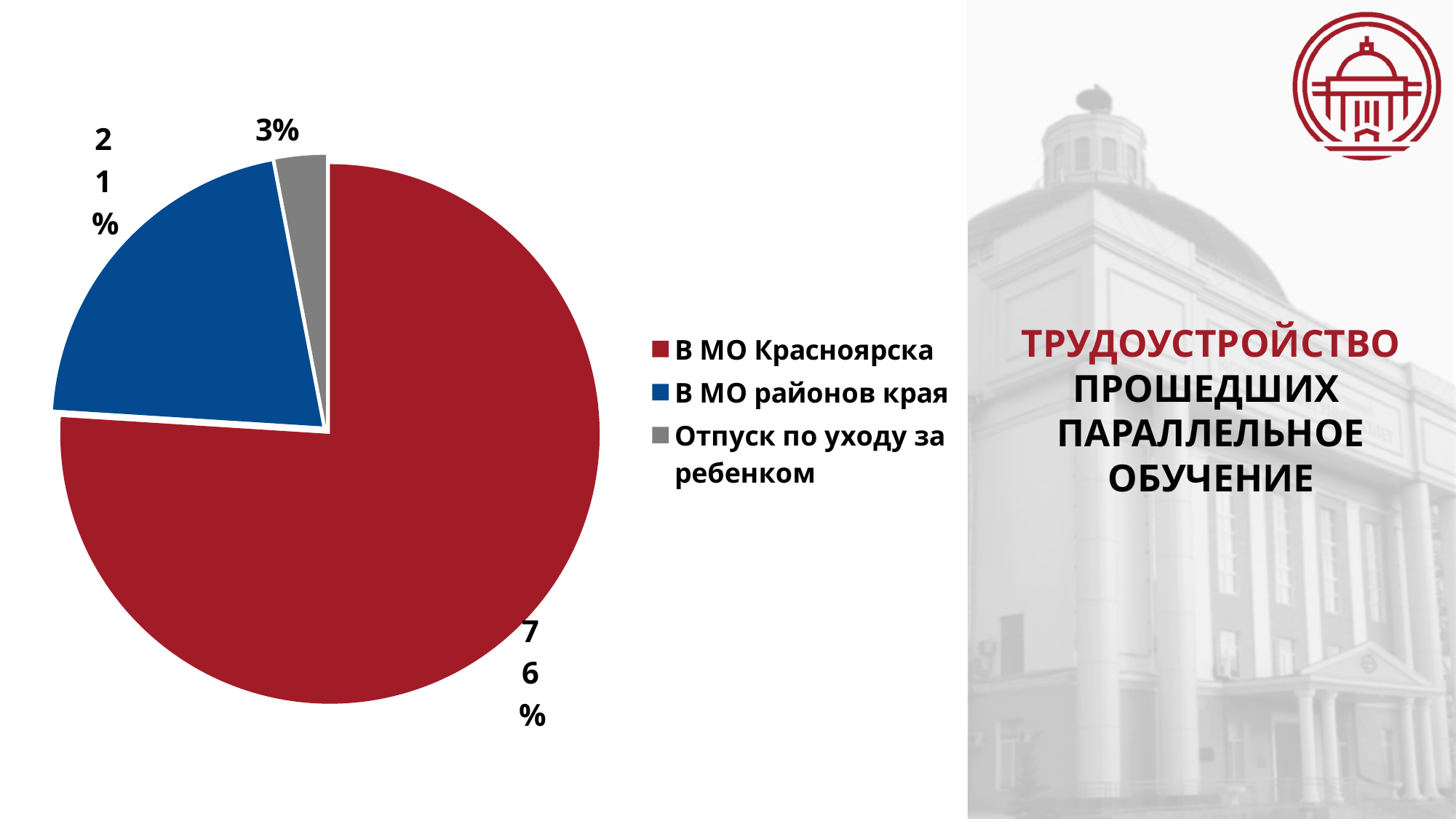
What colour is the slice for "В МО районов края"? blue What share of the pie does "В МО районов края" have? 21% What kind of chart is shown on the slide? pie chart What share of the pie does "В МО Красноярска" have? 76% What colour is the slice for "В МО Красноярска"? red Which is larger: the slice for "В МО районов края" or the slice for "Отпуск по уходу за ребенком"? В МО районов края What share of the pie does "Отпуск по уходу за ребенком" have? 3% Which category has the largest slice of the pie? В МО Красноярска What is the difference in percentage points between "В МО районов края" and "Отпуск по уходу за ребенком"? 18 Which category has the smallest slice of the pie? Отпуск по уходу за ребенком What is the difference in percentage points between "В МО Красноярска" and "В МО районов края"? 55 How many categories does the pie chart have? 3